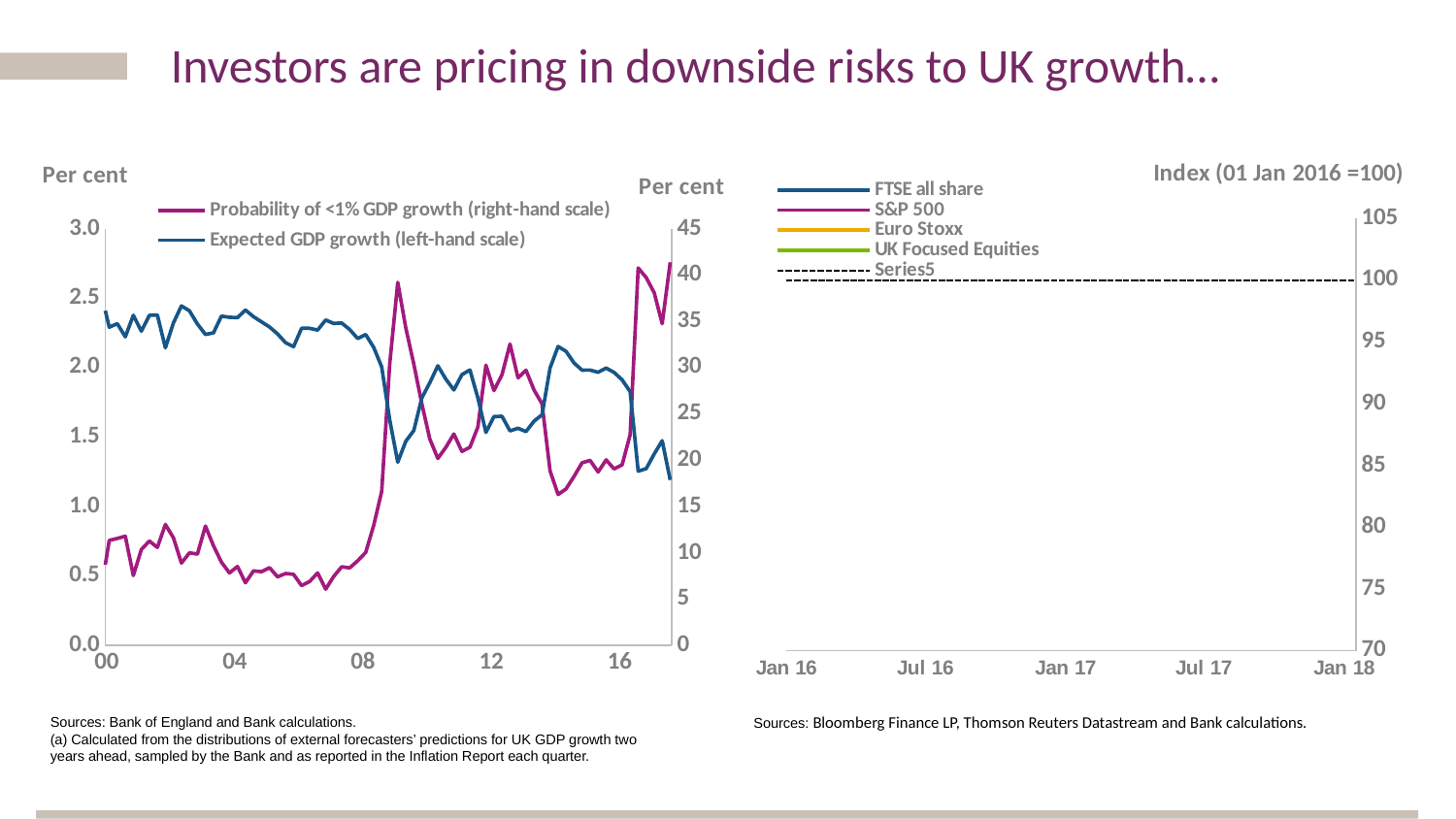
In the left-hand chart, is the value of Expected GDP growth at the end of the series (after 16) greater or less than 1.5? less How many series does the legend of the left-hand chart list? 2 In the left-hand chart, does the Expected GDP growth series overall rise or fall between 00 and 16? fall In the left-hand chart, which series is plotted against the right-hand scale? Probability of <1% GDP growth In the left-hand chart, is the value of Probability of <1% GDP growth at 04 greater or less than 15 on the right-hand scale? less In the left-hand chart, is the value of Expected GDP growth at 00 greater or less than 2.0? greater How many labelled ticks are on the x axis of the right-hand chart? 5 How many series does the legend of the right-hand chart (Index, 01 Jan 2016 = 100) list? 5 In the left-hand chart, does the Probability of <1% GDP growth series overall rise or fall between 00 and 16? rise In the right-hand chart, at what index value is the dashed horizontal line drawn? 100 What kind of chart is the left-hand chart on the slide? line chart